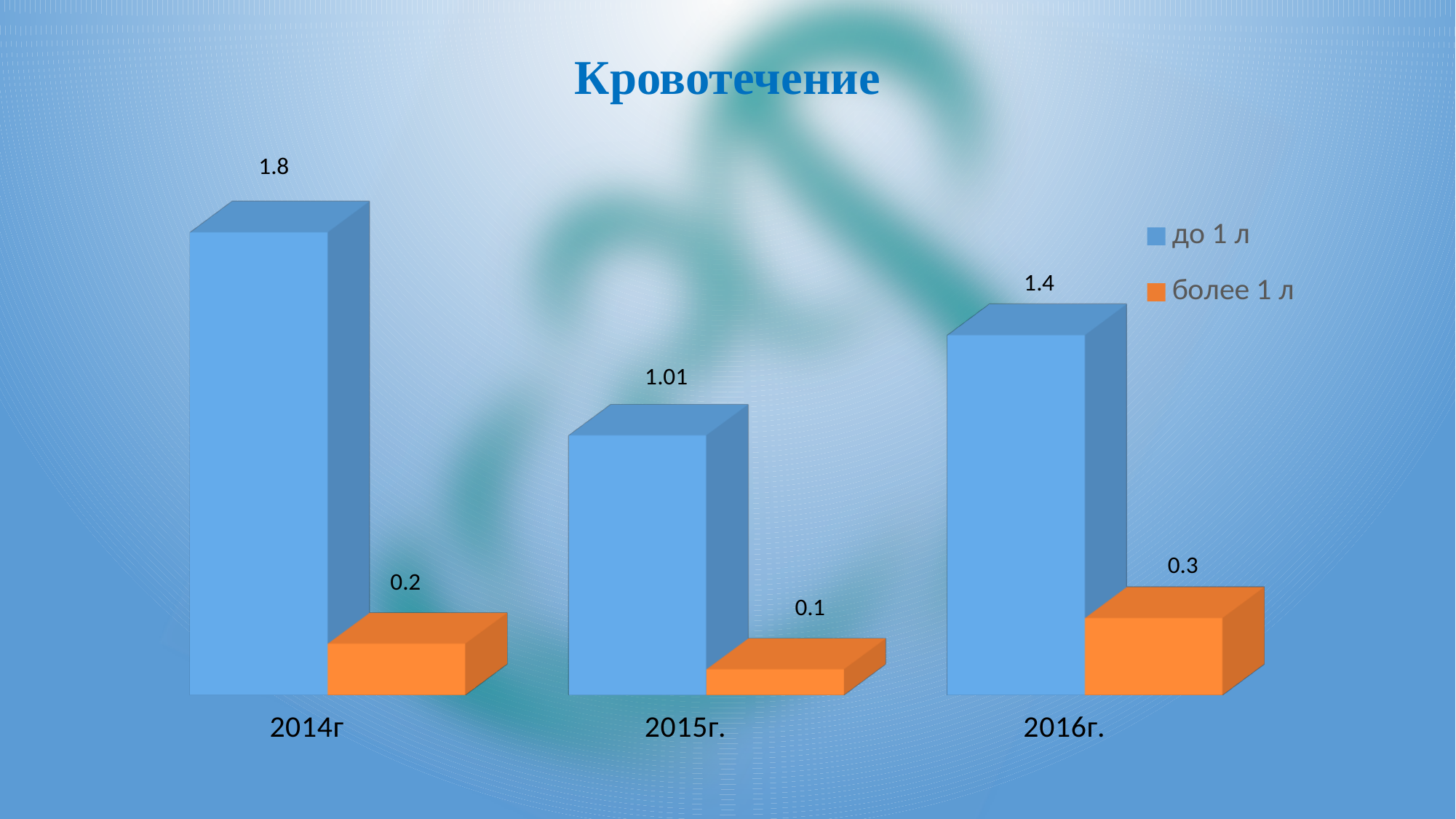
How many years are shown on the x axis? 3 What kind of chart is shown on the slide? Bar chart How many series does the legend list? 2 What is the title of the chart? Кровотечение What is the value for "до 1 л" in 2014г? 1.8 In which year is the value for "до 1 л" highest? 2014г What is the value for "более 1 л" in 2015г.? 0.1 Which is larger: the "более 1 л" value for 2014г or for 2016г.? 2016г. In which year is the value for "более 1 л" lowest? 2015г. What is the value for "более 1 л" in 2016г.? 0.3 What is the difference between the "до 1 л" values for 2014г and 2015г.? 0.79 What is the value for "до 1 л" in 2016г.? 1.4